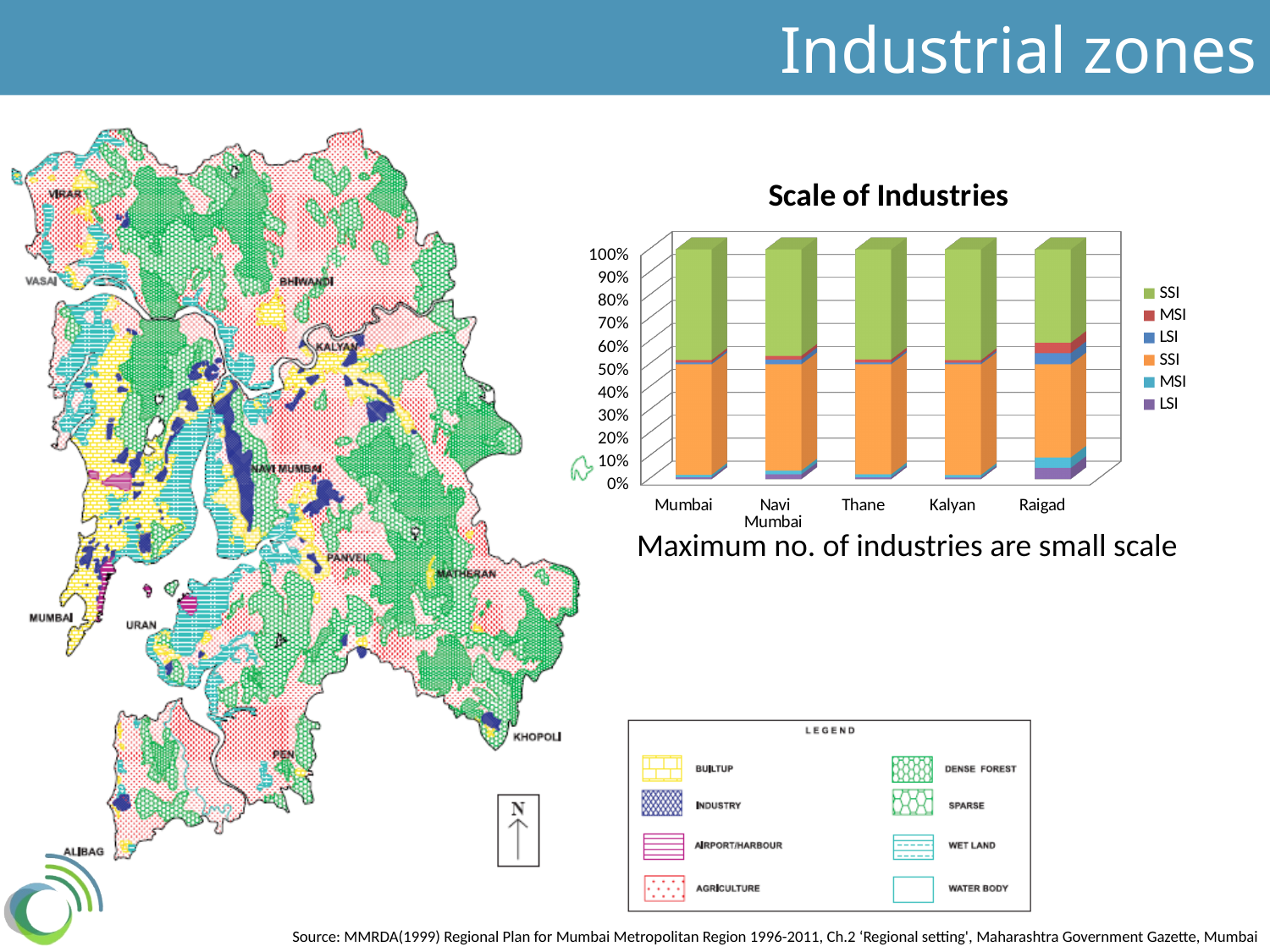
In the 'Scale of Industries' chart, is the top of the orange SSI segment for Mumbai greater or less than 40%? greater In the 'Scale of Industries' chart, which region has the largest red MSI segment? Raigad How many regions are shown on the x axis of the 'Scale of Industries' chart? 5 In the 'Scale of Industries' chart, is the green SSI segment for Mumbai greater or less than 30% of the bar? greater In the 'Scale of Industries' chart, is the light-blue MSI segment for Raigad larger or smaller than the light-blue MSI segment for Thane? larger Which region is the last category on the x axis of the 'Scale of Industries' chart? Raigad How many series does the legend of the 'Scale of Industries' chart list? 6 What is the title of the bar chart on the slide? Scale of Industries In the 'Scale of Industries' chart, what is the highest value shown on the y axis? 100% In the 'Scale of Industries' chart, is the purple LSI segment at the bottom of the Raigad bar greater or less than 10%? less What kind of chart is the 'Scale of Industries' chart? stacked bar chart